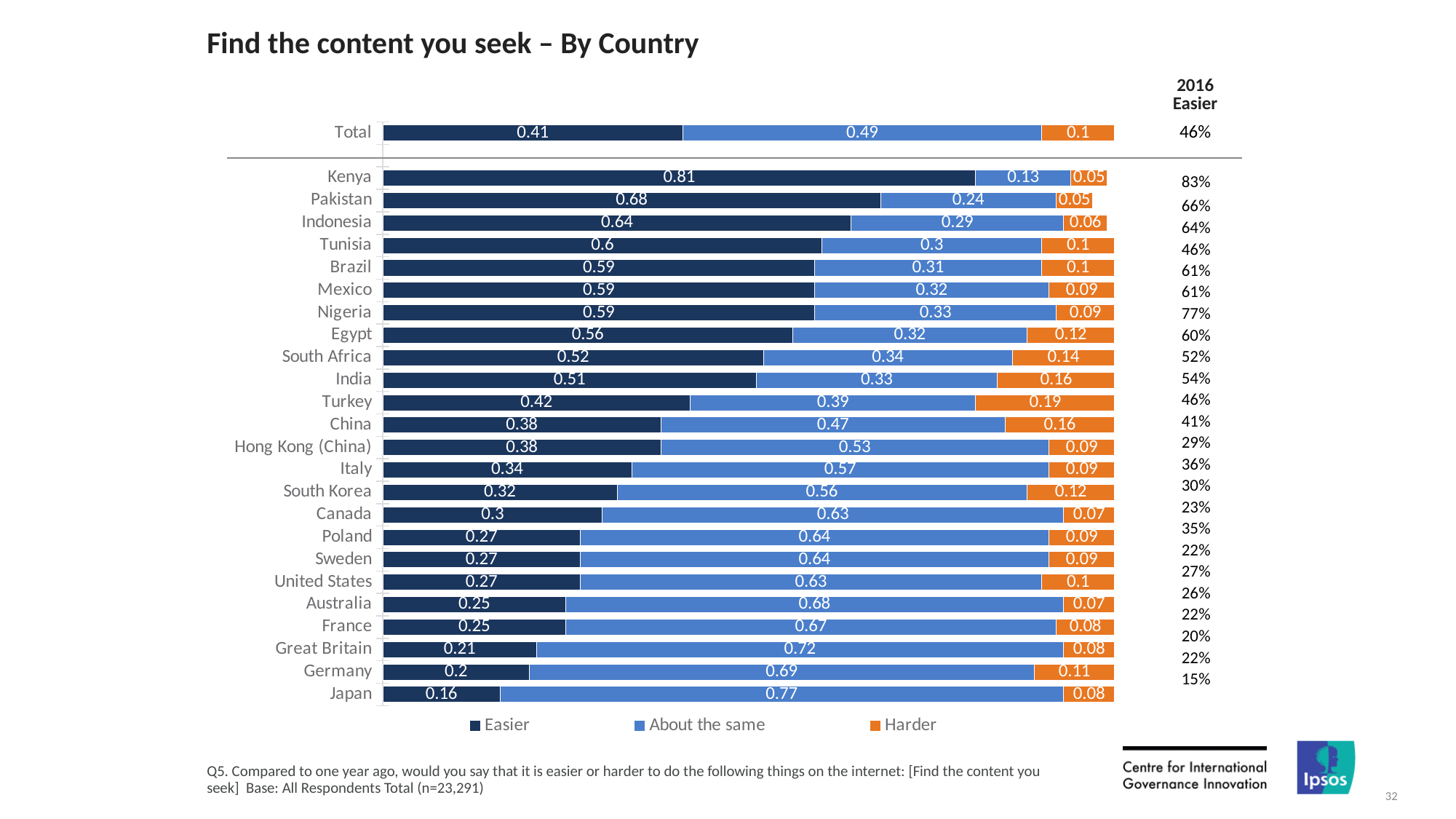
Which country has the lowest 'Easier' value? Japan Which has a larger 'Harder' value, India or Egypt? India What is the 2016 Easier percentage shown for Nigeria? 77% What is the 'Harder' value for Turkey? 0.19 What is the 'About the same' value for Japan? 0.77 Which country has the highest 'Easier' value? Kenya How many series does the legend list? 3 What is the total of the stacked bar for Total? 1 What is the 'Easier' value for Kenya? 0.81 Which country has the highest 'Harder' value? Turkey What is the difference between the 'Easier' values for Kenya and Japan? 0.65 What type of chart is shown on the slide? Stacked bar chart